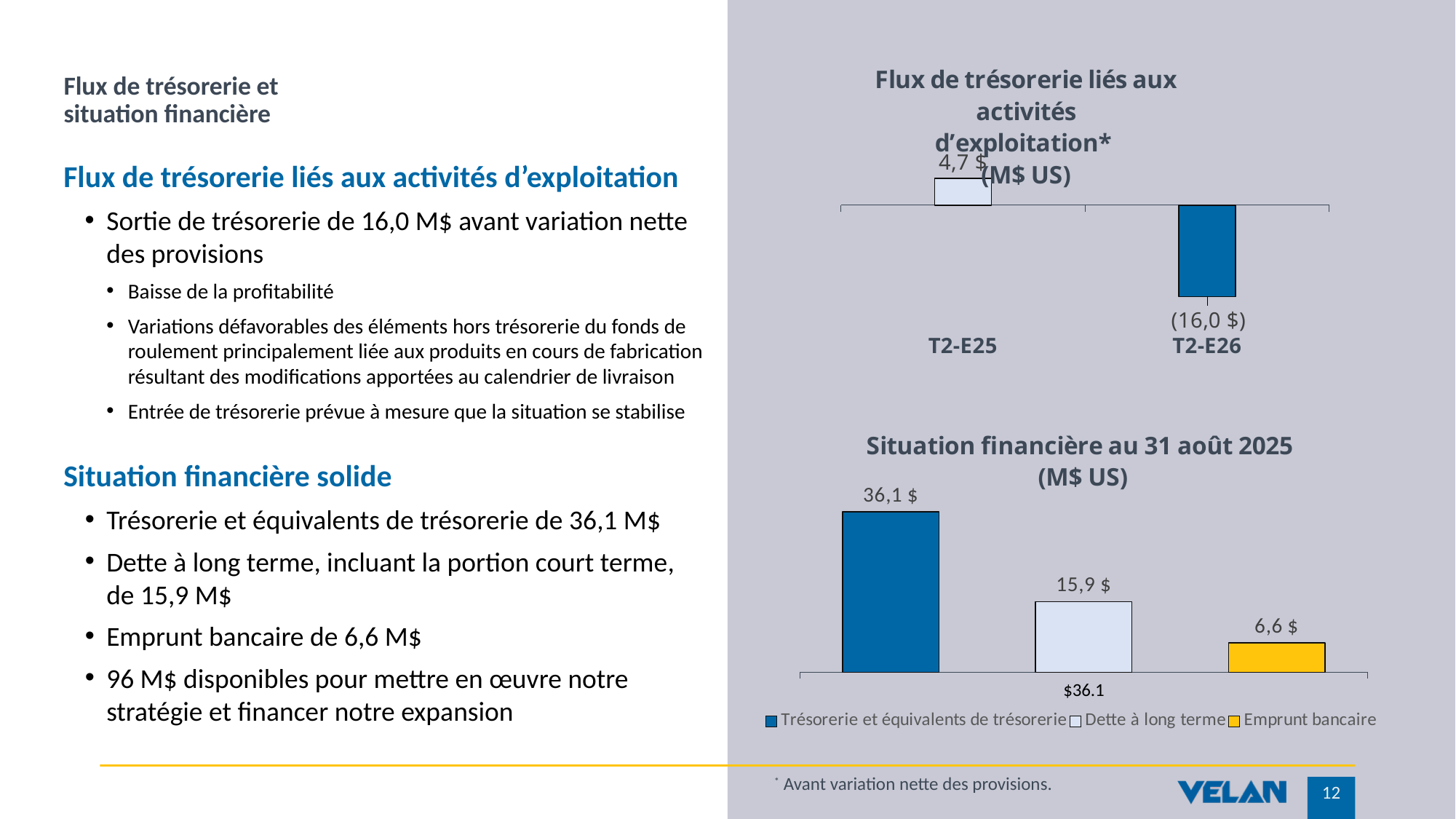
In the chart 'Situation financière au 31 août 2025 (M$ US)', what is the value for Trésorerie et équivalents de trésorerie? 36,1 $ In the chart 'Flux de trésorerie liés aux activités d'exploitation* (M$ US)', do the values rise or fall from T2-E25 to T2-E26? fall In the chart 'Flux de trésorerie liés aux activités d'exploitation* (M$ US)', what is the value for T2-E26? (16,0 $) In the chart 'Flux de trésorerie liés aux activités d'exploitation* (M$ US)', which period has the higher value? T2-E25 What kind of chart is 'Flux de trésorerie liés aux activités d'exploitation* (M$ US)'? bar chart In the chart 'Situation financière au 31 août 2025 (M$ US)', which series has the lowest value? Emprunt bancaire How many series does the legend of the chart 'Situation financière au 31 août 2025 (M$ US)' list? 3 In the chart 'Flux de trésorerie liés aux activités d'exploitation* (M$ US)', how many periods are shown? 2 In the chart 'Flux de trésorerie liés aux activités d'exploitation* (M$ US)', what is the value for T2-E25? 4,7 $ In the chart 'Situation financière au 31 août 2025 (M$ US)', what is the value for Emprunt bancaire? 6,6 $ In the chart 'Situation financière au 31 août 2025 (M$ US)', what is the value for Dette à long terme? 15,9 $ In the chart 'Situation financière au 31 août 2025 (M$ US)', what is the difference between Trésorerie et équivalents de trésorerie and Dette à long terme? 20,2 $